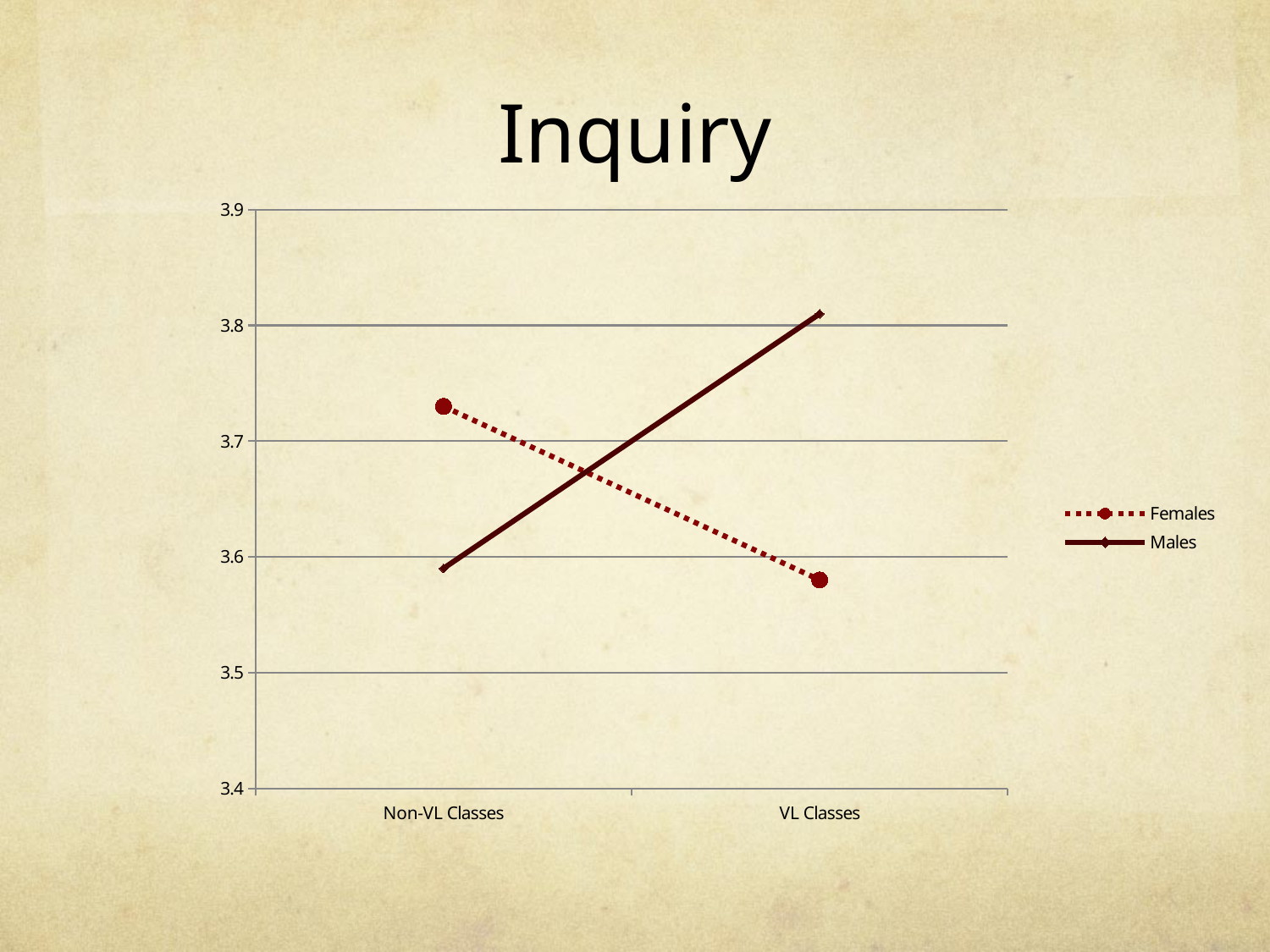
Do the values for Females rise or fall from Non-VL Classes to VL Classes? fall How many series does the legend list? 2 Is the value for Females in VL Classes greater or less than 3.7? less In which category does the Males series reach its highest value? VL Classes For VL Classes, which series has the higher value, Females or Males? Males For Non-VL Classes, which series has the higher value, Females or Males? Females What is the title of the chart? Inquiry Do the values for Males rise or fall from Non-VL Classes to VL Classes? rise What kind of chart is shown on the slide? line chart How many categories are shown on the x axis? 2 Which series is drawn with a dotted line? Females Is the value for Males in VL Classes greater or less than 3.7? greater